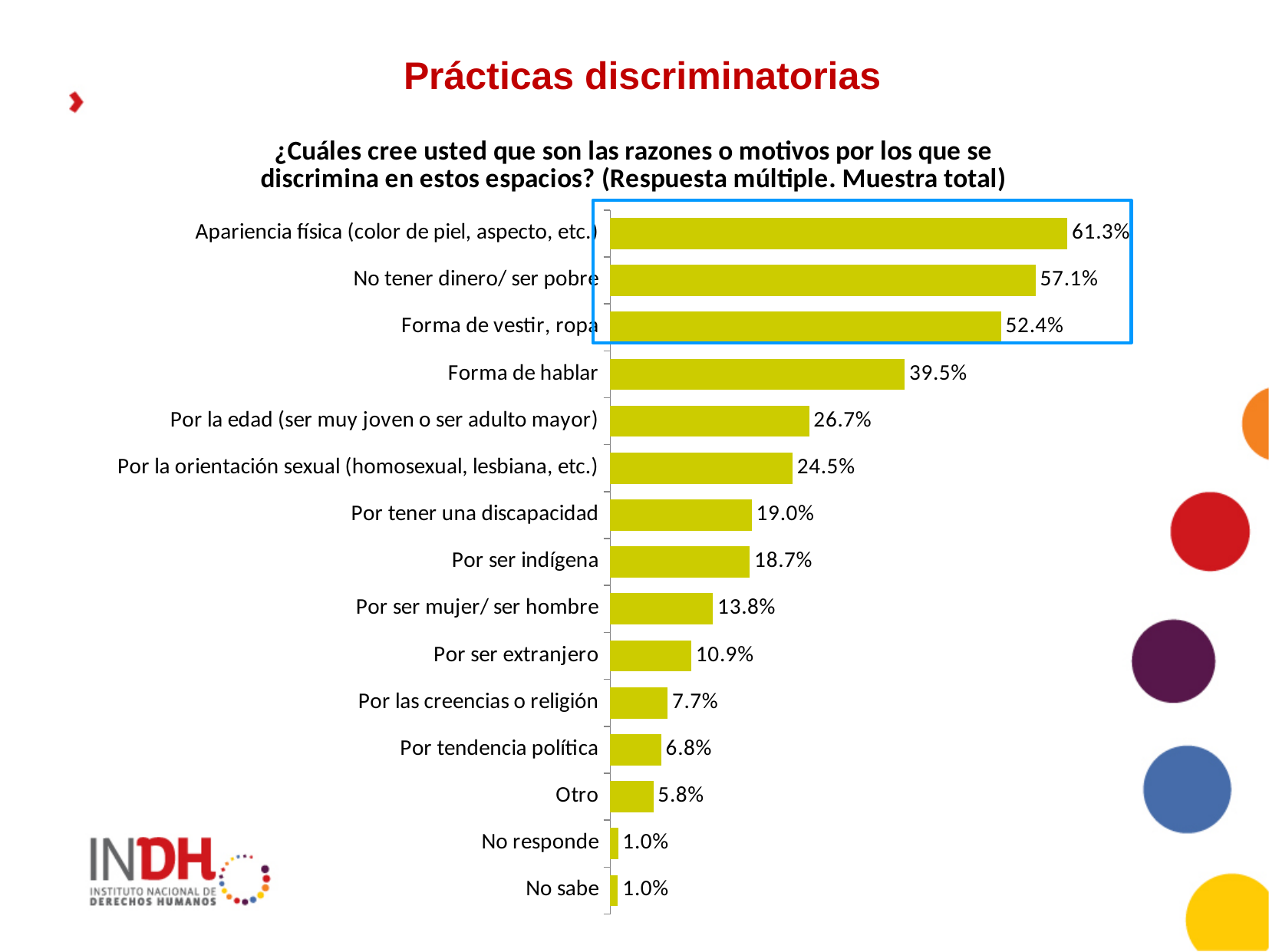
What is the value for "Forma de hablar"? 39.5% What is the value for "Por ser indígena"? 18.7% How many categories are enclosed by the blue highlight box? 3 Which is larger, "Por tener una discapacidad" or "Por ser mujer/ ser hombre"? Por tener una discapacidad What is the difference between "Por la edad (ser muy joven o ser adulto mayor)" and "Por la orientación sexual (homosexual, lesbiana, etc.)"? 2.2% Which category has the highest value? Apariencia física (color de piel, aspecto, etc.) What kind of chart is shown on the slide? Bar chart What is the value for "Por tendencia política"? 6.8% What is the difference between "No tener dinero/ ser pobre" and "Forma de vestir, ropa"? 4.7% What percentage is shown for "Por ser extranjero"? 10.9% How many categories are shown in the chart? 15 Which is larger, "Otro" or "Por las creencias o religión"? Por las creencias o religión